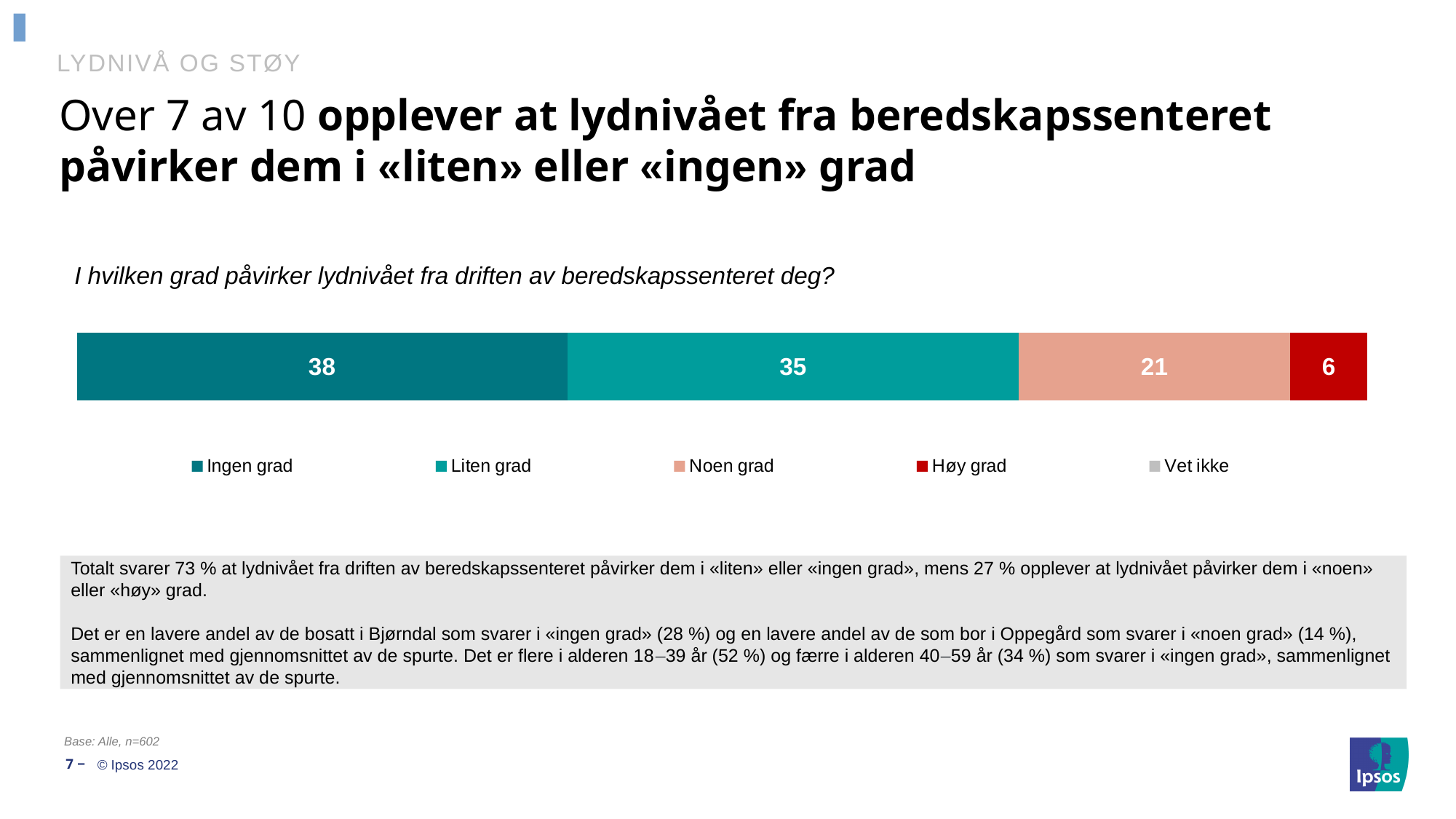
What kind of chart is shown on the slide? Stacked bar chart Which response category has the smallest labelled segment in the bar? Høy grad What value is shown for "Ingen grad"? 38 How many series does the legend list? 5 What value is shown for "Liten grad"? 35 What value is shown for "Høy grad"? 6 What is the total of the labelled segments in the stacked bar? 100 What is the difference between the values for "Noen grad" and "Høy grad"? 15 What is the difference between the values for "Ingen grad" and "Liten grad"? 3 What value is shown for "Noen grad"? 21 Which response category has the largest segment in the bar? Ingen grad Which is larger, the value for "Liten grad" or the value for "Noen grad"? Liten grad